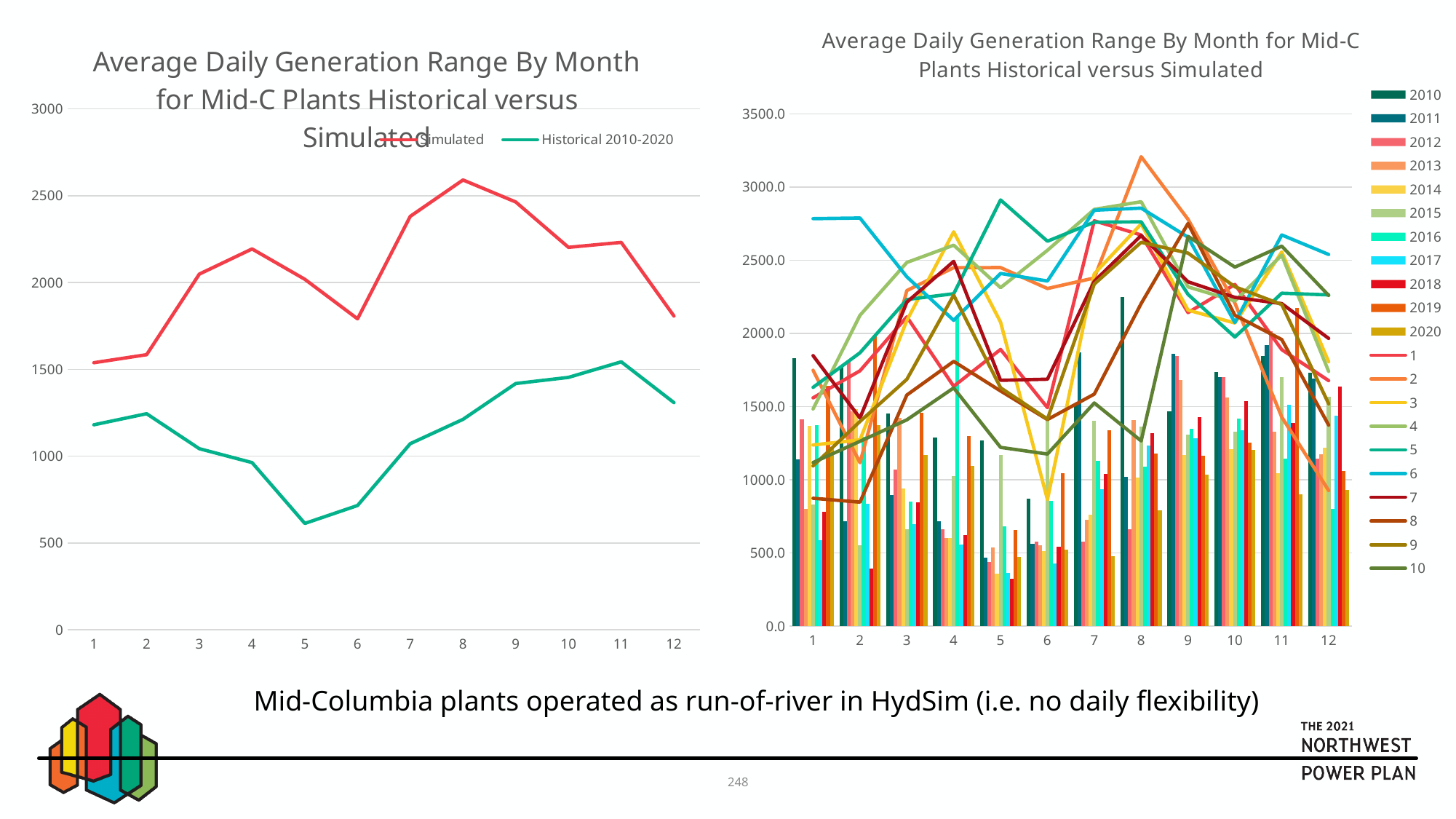
On the left chart, in which month does the Historical 2010-2020 series reach its lowest value? 5 On the left chart, in which month does the Historical 2010-2020 series reach its highest value? 11 On the left chart, in which month does the Simulated series reach its highest value? 8 On the left chart, how many series does the legend list? 2 On the left chart, how many months are plotted along the x axis? 12 On the left chart, does the Historical 2010-2020 series rise or fall from month 5 to month 11? Rise On the left chart, is the Simulated value for month 6 greater or less than 2000? less On the left chart, is the Simulated value for month 8 greater or less than 2500? greater On the right chart, how many entries does the legend list? 21 On the left chart, which series has the larger value in month 5, Simulated or Historical 2010-2020? Simulated On the left chart, is the Historical 2010-2020 value for month 5 greater or less than 1000? less On the left chart, what kind of chart is shown? Line chart